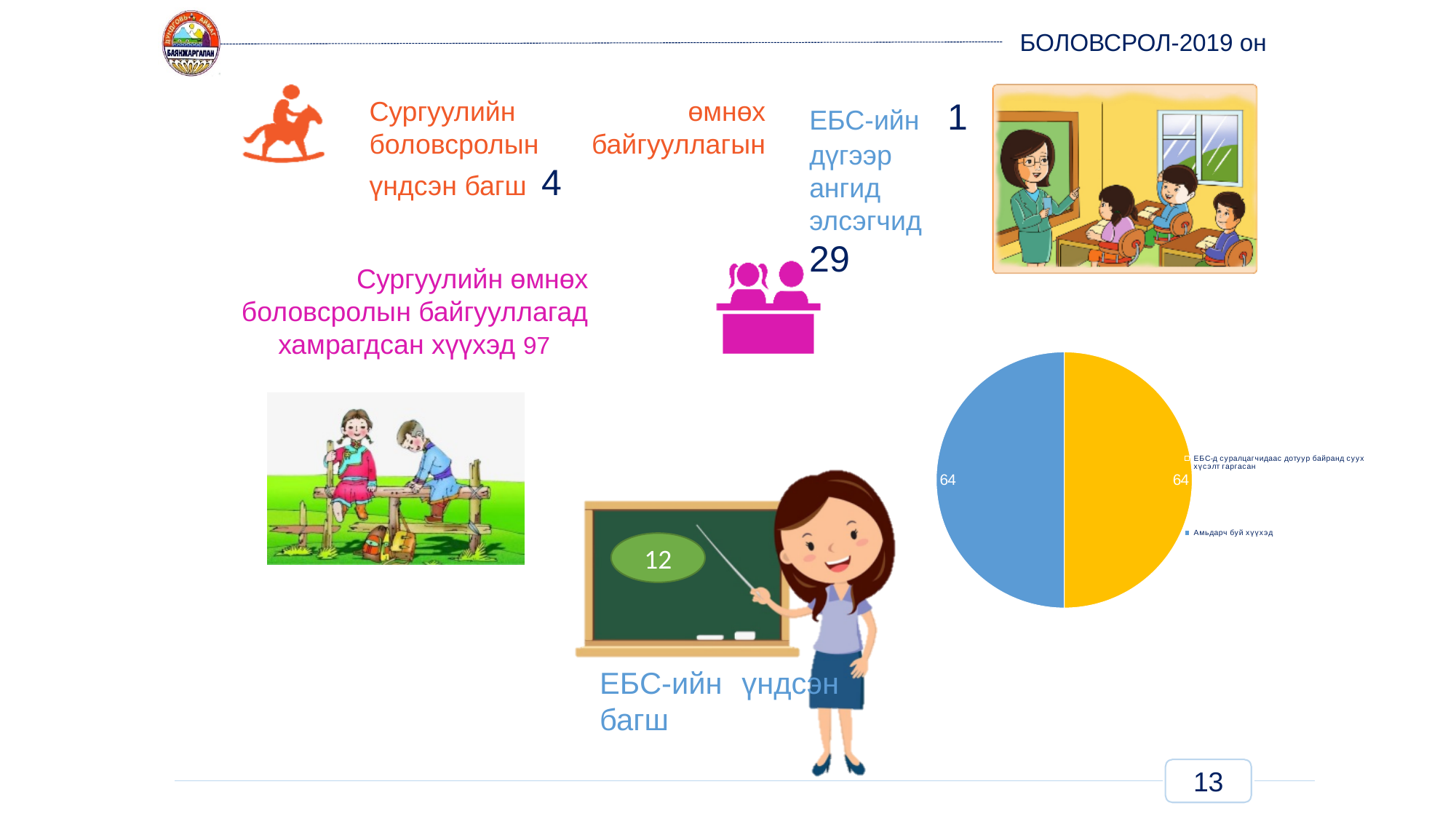
What is the value of the slice labelled "Амьдарч буй хүүхэд" in the pie chart? 64 What kind of chart is shown on the right side of the slide? pie chart Which colour is used for the "ЕБС-д суралцагчидаас дотуур байранд суух хүсэлт гаргасан" slice in the pie chart? yellow What is the total of the two values shown in the pie chart? 128 How many entries does the legend of the pie chart list? 2 What is the value of the slice labelled "ЕБС-д суралцагчидаас дотуур байранд суух хүсэлт гаргасан" in the pie chart? 64 How many slices does the pie chart have? 2 What share of the pie chart does the "Амьдарч буй хүүхэд" slice represent? 50% What is the difference between the two slice values in the pie chart? 0 Which colour is used for the "Амьдарч буй хүүхэд" slice in the pie chart? blue What share of the pie chart does the "ЕБС-д суралцагчидаас дотуур байранд суух хүсэлт гаргасан" slice represent? 50%